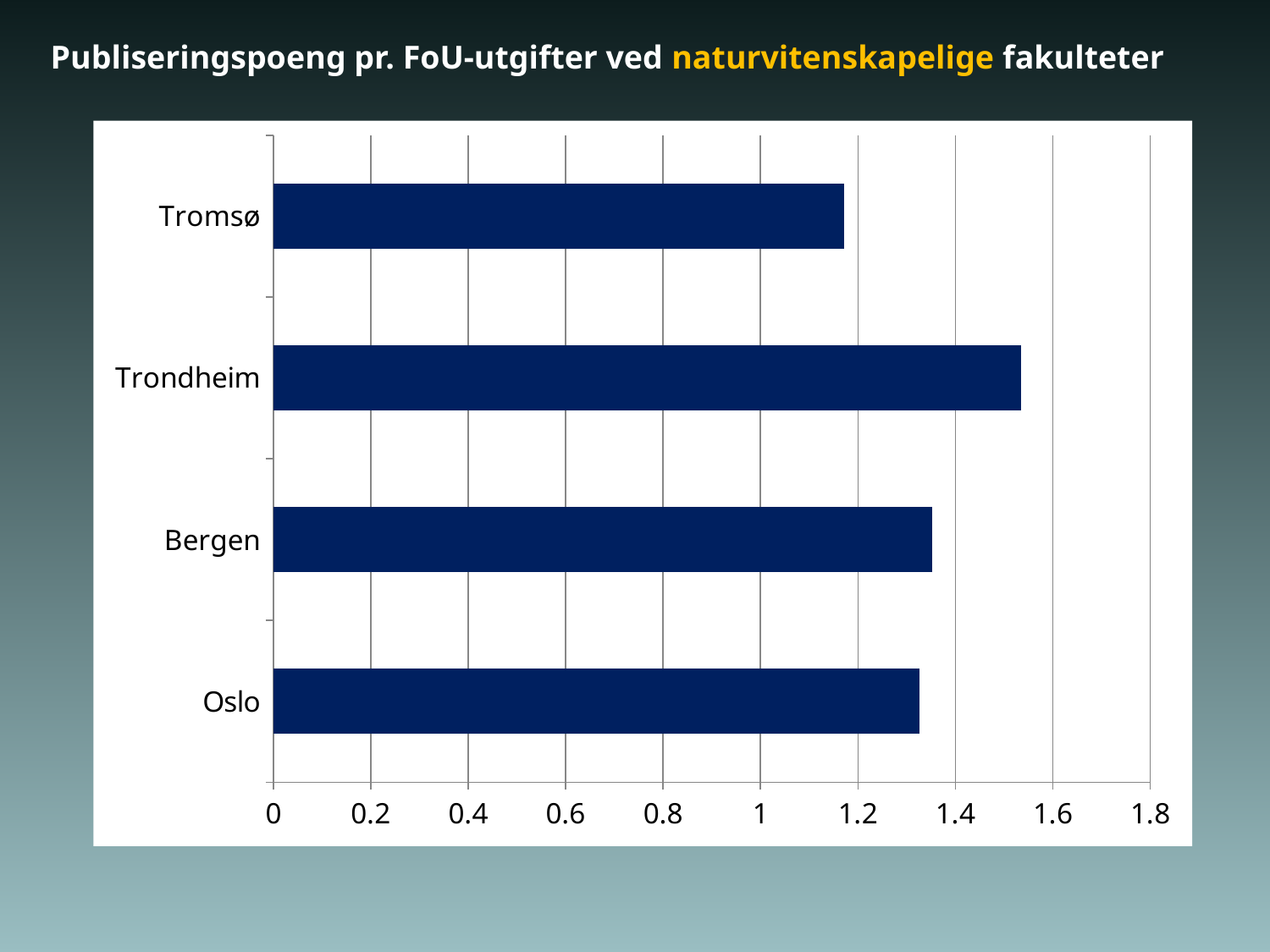
What kind of chart is shown on the slide? bar chart Is the value for Tromsø greater or less than 1? greater Is the value for Trondheim greater or less than 1.6? less Which category has the lowest value? Tromsø Which is larger, the value for Trondheim or the value for Tromsø? Trondheim Which is larger, the value for Bergen or the value for Tromsø? Bergen What is the highest value shown on the x axis? 1.8 How many categories are plotted in the chart? 4 Is the value for Bergen greater or less than 1.2? greater Which category has the highest value? Trondheim